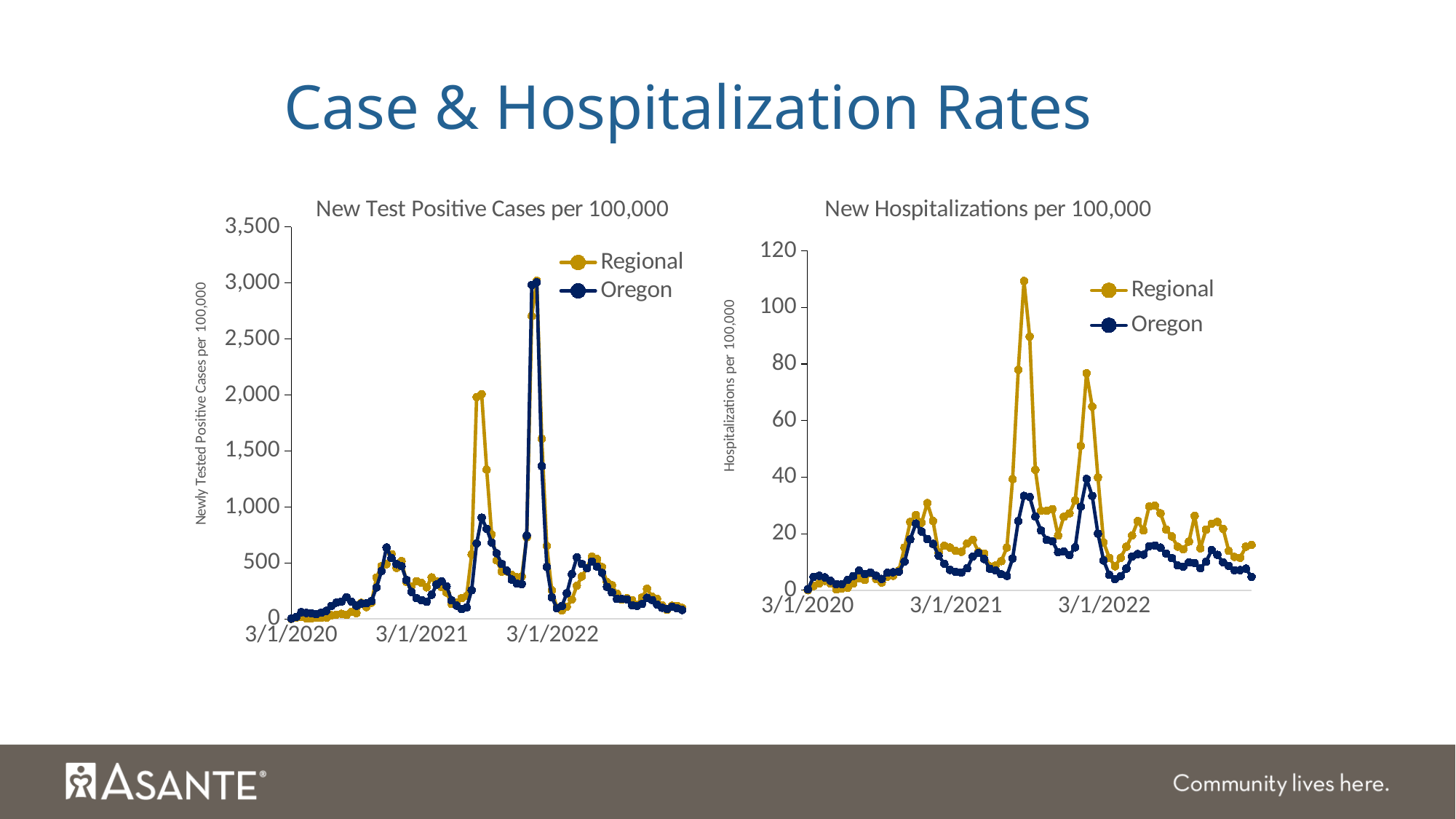
What kind of chart is the 'New Test Positive Cases per 100,000' chart? line chart What is the y-axis label of the 'New Test Positive Cases per 100,000' chart? Newly Tested Positive Cases per 100,000 In the 'New Test Positive Cases per 100,000' chart, is the highest Regional value greater or less than 2,500? greater In the 'New Hospitalizations per 100,000' chart, which series reaches the highest peak? Regional In the 'New Test Positive Cases per 100,000' chart, is the Oregon peak in mid-2021 greater or less than 1,500? less In the 'New Test Positive Cases per 100,000' chart, which series has the higher peak in mid-2021, Regional or Oregon? Regional How many series does the legend of the 'New Test Positive Cases per 100,000' chart list? 2 What is the highest value shown on the y axis of the 'New Hospitalizations per 100,000' chart? 120 In the 'New Hospitalizations per 100,000' chart, is the highest Oregon value greater or less than 60? less What kind of chart is the 'New Hospitalizations per 100,000' chart? line chart In the 'New Hospitalizations per 100,000' chart, do the Regional values rise or fall from the peak in mid-2021 to 3/1/2022? fall